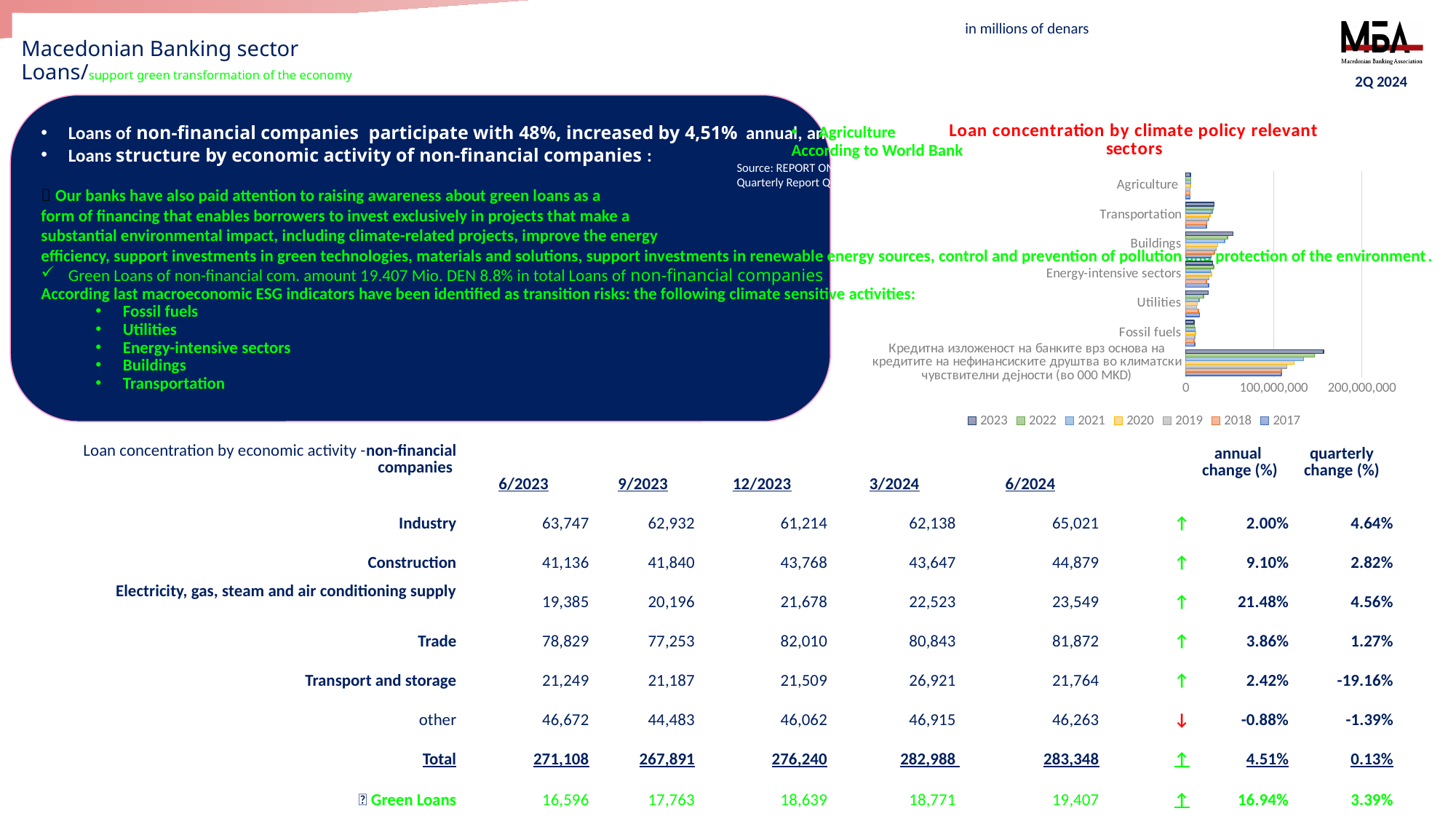
Is the 2023 value for Agriculture greater or less than 100,000,000? less What kind of chart is shown on the slide? bar chart What is the title of the chart? Loan concentration by climate policy relevant sectors How many series does the legend of the chart list? 7 Is the 2023 value for Buildings greater or less than 100,000,000? less How many categories are plotted on the vertical axis of the chart? 7 Among the six named sectors (excluding the bottom total category), which has the longest 2023 bar? Buildings Which has the larger 2023 value, Buildings or Agriculture? Buildings Among the six named sectors (excluding the bottom total category), which has the shortest 2023 bar? Agriculture Which year is listed first in the chart's legend? 2023 Is the 2023 value for the bottom category (total credit exposure) greater or less than 100,000,000? greater Which has the larger 2023 value, Transportation or Fossil fuels? Transportation